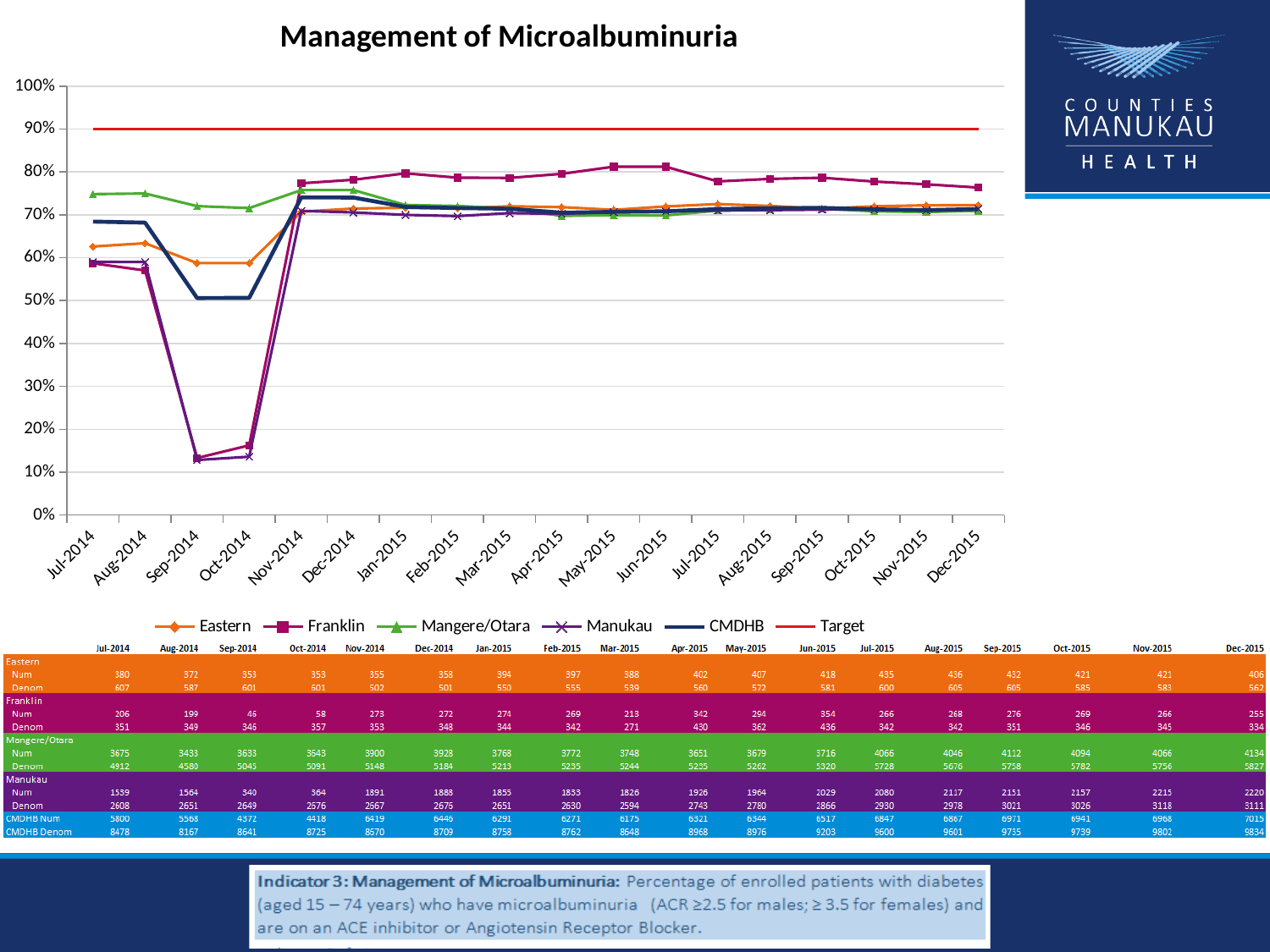
What is the title of the chart? Management of Microalbuminuria How many months are plotted along the x axis of the chart? 18 Is the Target line greater or less than 80%? greater What kind of chart is shown on the slide? Line chart Is the value for Mangere/Otara in Jul-2014 greater or less than 70%? greater How many series does the chart legend list? 6 Is the value for Franklin in Sep-2014 greater or less than 20%? less Which series has the highest value in Dec-2015? Target In Jun-2015, which is larger: the value for Franklin or the value for Mangere/Otara? Franklin In Jul-2014, which is larger: the value for Mangere/Otara or the value for Eastern? Mangere/Otara